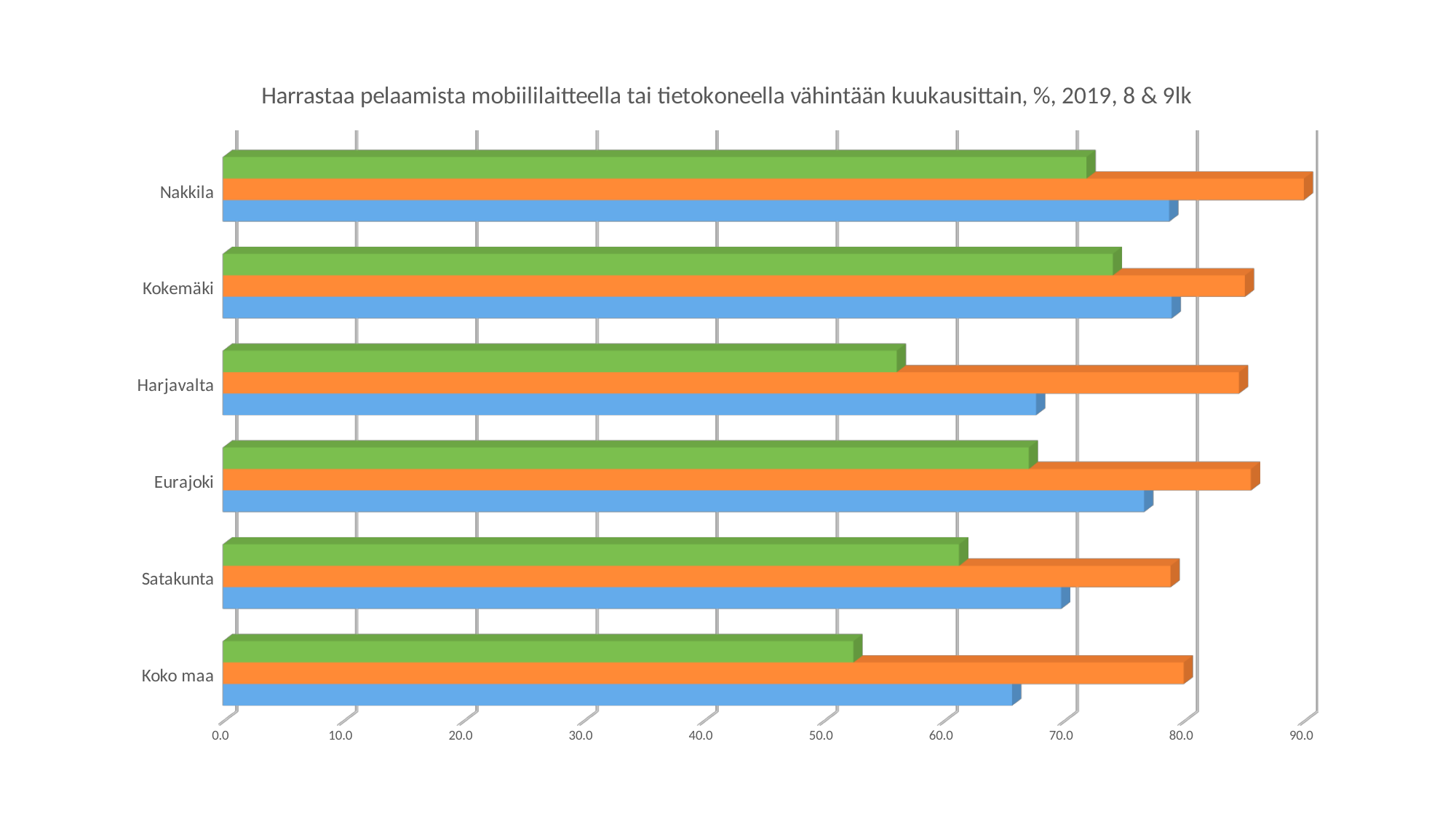
Which is larger, the green bar for Harjavalta or the green bar for Eurajoki? Eurajoki Is the value of the green bar for Koko maa greater or less than 60? less Which year does the chart title say the data is from? 2019 What kind of chart is shown on the slide? bar chart How many categories (areas) are shown on the y axis of the chart? 6 Which category has the longest orange bar? Nakkila Is the value of the blue bar for Satakunta greater or less than 60? greater How many bars are plotted for each category in the chart? 3 Is the value of the green bar for Kokemäki greater or less than 70? greater For Koko maa, which bar is longer, the orange one or the green one? the orange one